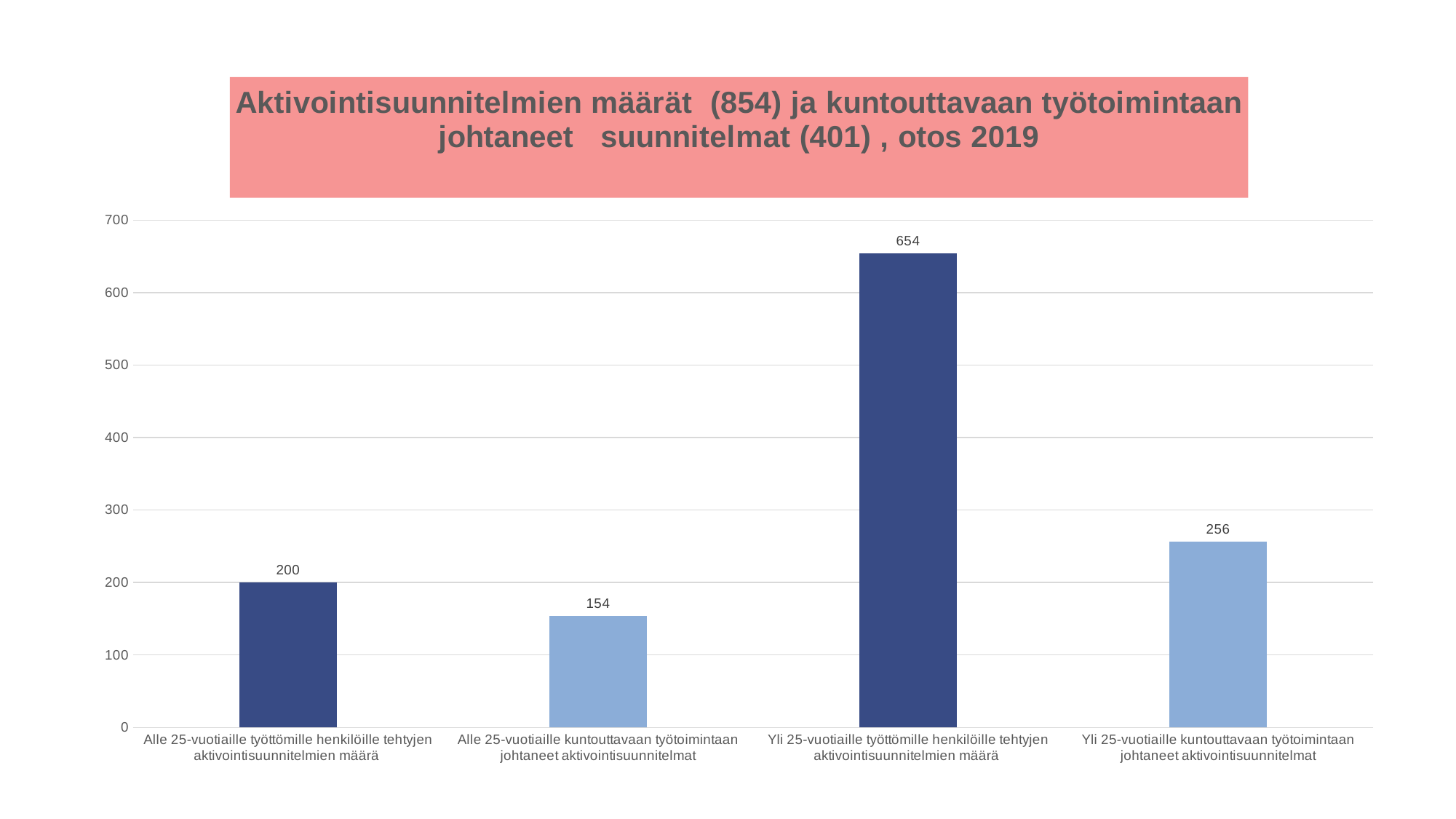
Which category has the highest value? Yli 25-vuotiaille työttömille henkilöille tehtyjen aktivointisuunnitelmien määrä What is the difference between the values for 'Yli 25-vuotiaille työttömille henkilöille tehtyjen aktivointisuunnitelmien määrä' and 'Yli 25-vuotiaille kuntouttavaan työtoimintaan johtaneet aktivointisuunnitelmat'? 398 Which category has the lowest value? Alle 25-vuotiaille kuntouttavaan työtoimintaan johtaneet aktivointisuunnitelmat What is the value for 'Alle 25-vuotiaille kuntouttavaan työtoimintaan johtaneet aktivointisuunnitelmat'? 154 What is the value for 'Yli 25-vuotiaille kuntouttavaan työtoimintaan johtaneet aktivointisuunnitelmat'? 256 What is the difference between the values for 'Alle 25-vuotiaille työttömille henkilöille tehtyjen aktivointisuunnitelmien määrä' and 'Alle 25-vuotiaille kuntouttavaan työtoimintaan johtaneet aktivointisuunnitelmat'? 46 Which is larger: the value for 'Yli 25-vuotiaille kuntouttavaan työtoimintaan johtaneet aktivointisuunnitelmat' or 'Alle 25-vuotiaille työttömille henkilöille tehtyjen aktivointisuunnitelmien määrä'? Yli 25-vuotiaille kuntouttavaan työtoimintaan johtaneet aktivointisuunnitelmat What is the value for 'Yli 25-vuotiaille työttömille henkilöille tehtyjen aktivointisuunnitelmien määrä'? 654 What is the value for 'Alle 25-vuotiaille työttömille henkilöille tehtyjen aktivointisuunnitelmien määrä'? 200 What is the title of the chart? Aktivointisuunnitelmien määrät (854) ja kuntouttavaan työtoimintaan johtaneet suunnitelmat (401) , otos 2019 How many categories are shown on the chart? 4 What kind of chart is shown on the slide? Bar chart